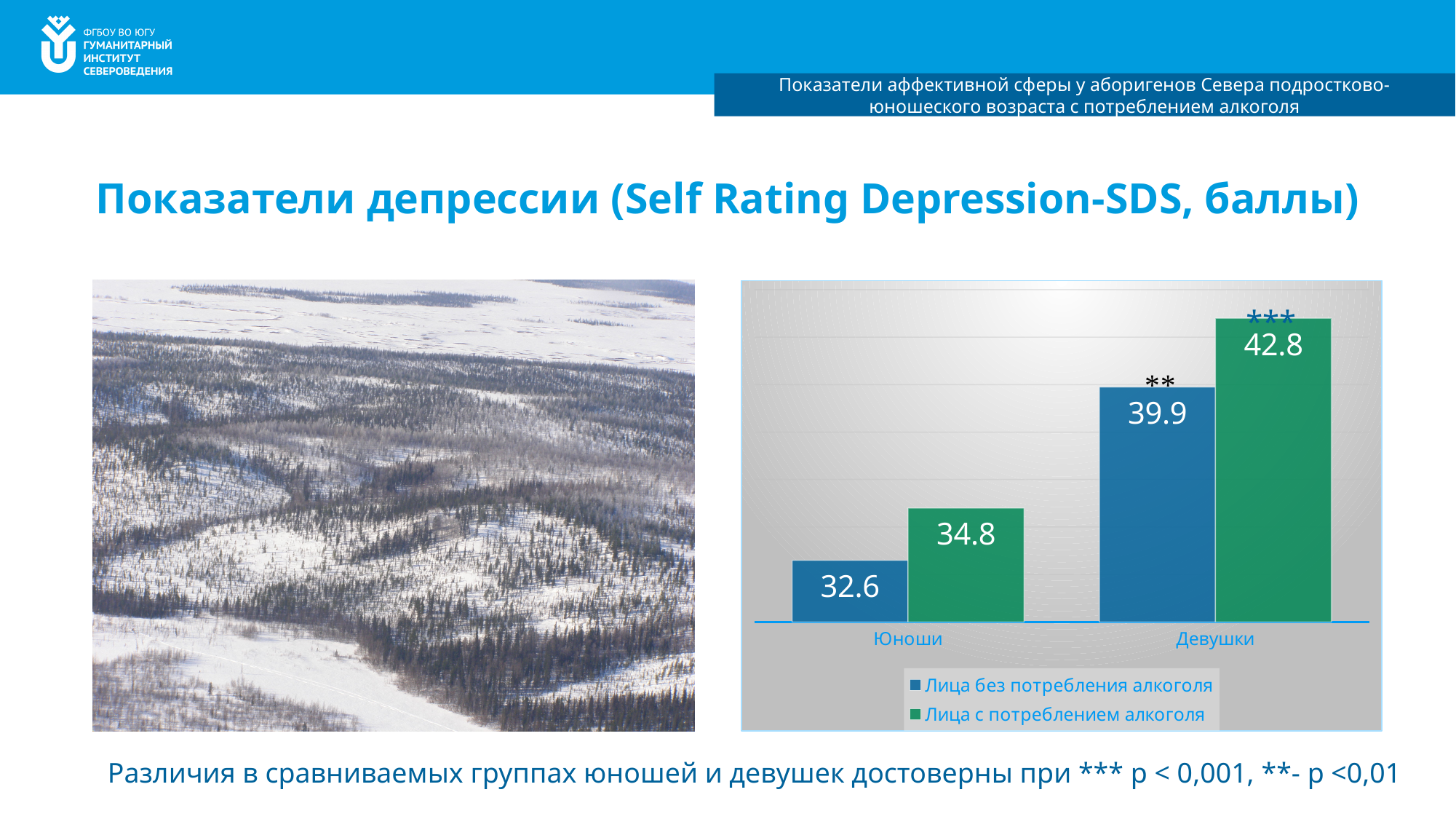
What is the difference between the two values for Девушки? 2.9 How many series does the chart legend list? 2 Which is larger: the value for Девушки without alcohol consumption (Лица без потребления алкоголя) or the value for Юноши with alcohol consumption (Лица с потреблением алкоголя)? Девушки, Лица без потребления алкоголя What is the difference between the two values for Юноши? 2.2 What is the value for Юноши in the series Лица с потреблением алкоголя? 34.8 What kind of chart is shown on the slide? Bar chart Which bar has the highest value on the chart? Девушки, Лица с потреблением алкоголя How many categories are shown on the x axis of the chart? 2 What is the value for Девушки in the series Лица с потреблением алкоголя? 42.8 What is the value for Девушки in the series Лица без потребления алкоголя? 39.9 Which bar has the lowest value on the chart? Юноши, Лица без потребления алкоголя What is the value for Юноши in the series Лица без потребления алкоголя? 32.6